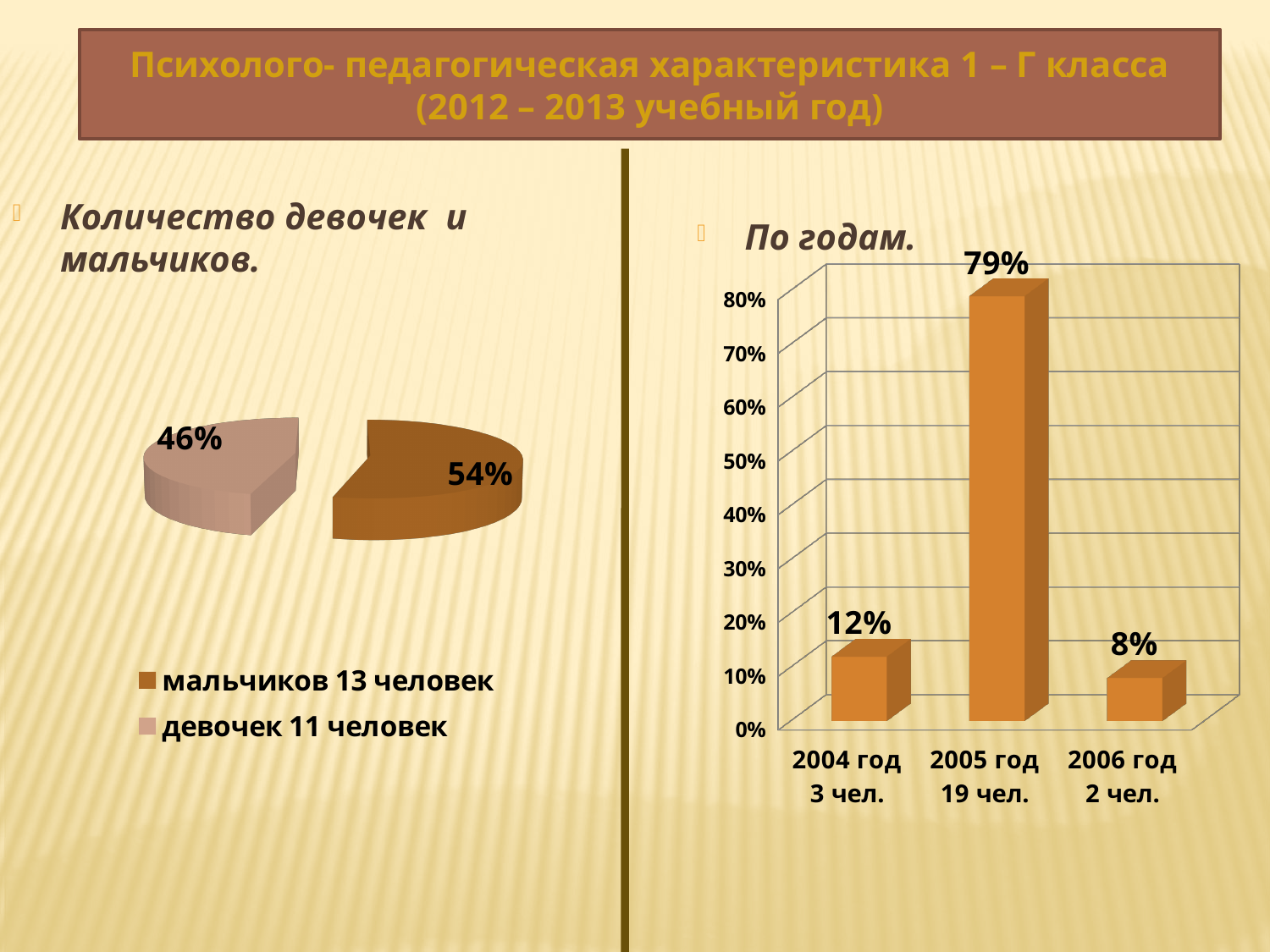
In the bar chart on the right (По годам), which year has the lowest value? 2006 год In the bar chart on the right (По годам), which year has the highest value? 2005 год In the bar chart on the right (По годам), what is the value for 2004 год 3 чел.? 12% In the pie chart on the left, what percentage is shown for девочек 11 человек? 46% In the pie chart on the left, which slice is larger, мальчиков or девочек? мальчиков In the pie chart on the left, how many entries does the legend list? 2 In the bar chart on the right (По годам), what is the value for 2006 год 2 чел.? 8% In the bar chart on the right (По годам), what is the difference between the values for 2005 год and 2004 год? 67% In the pie chart on the left, what percentage is shown for мальчиков 13 человек? 54% What kind of chart is shown on the left side of the slide? pie chart In the bar chart on the right (По годам), how many categories are shown on the x axis? 3 In the bar chart on the right (По годам), what is the value for 2005 год 19 чел.? 79%